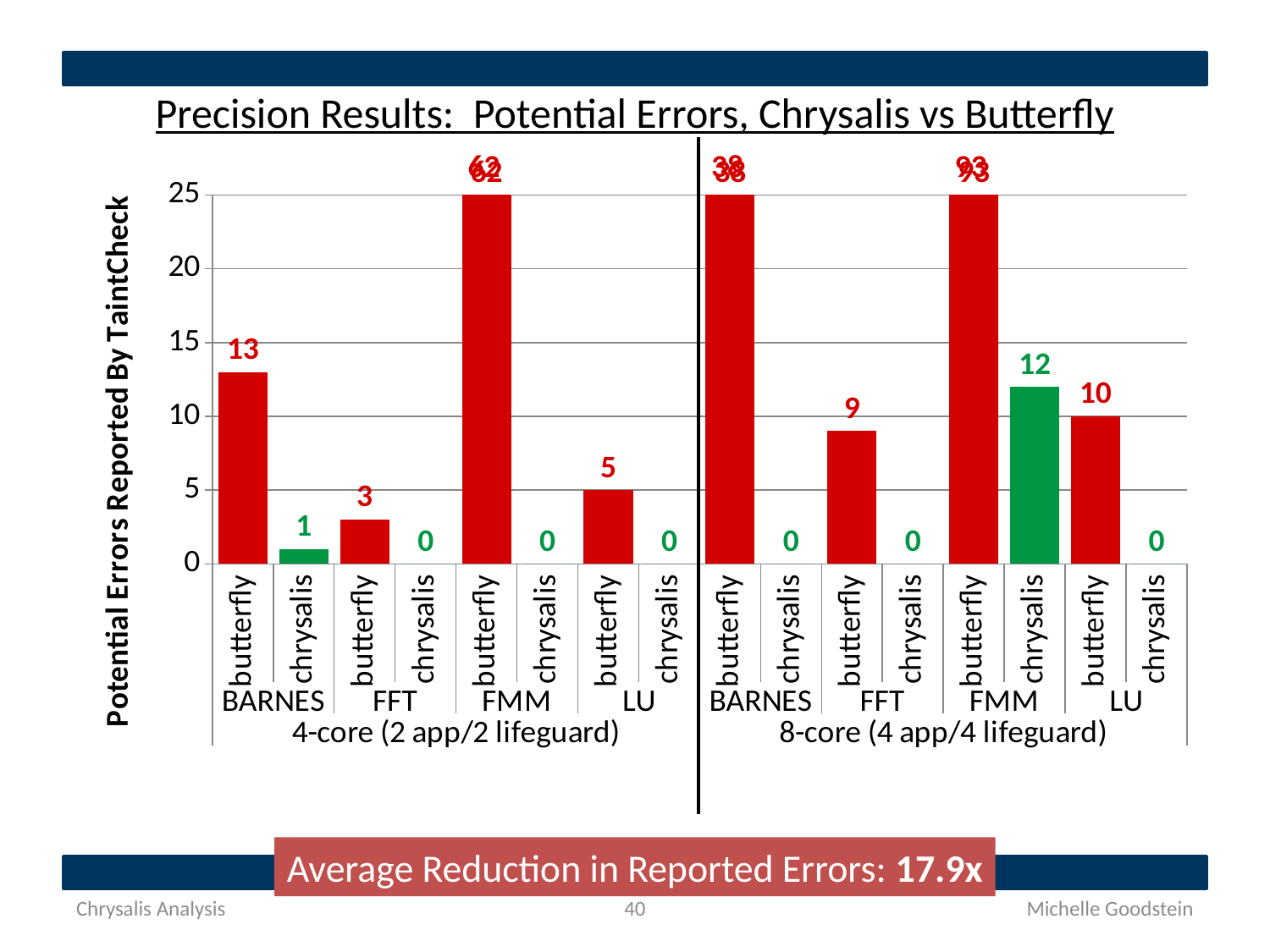
What kind of chart is shown on the slide? bar chart What is the value for butterfly on FFT in the 8-core (4 app/4 lifeguard) configuration? 9 What is the difference between butterfly and chrysalis on BARNES in the 4-core (2 app/2 lifeguard) configuration? 12 What is the value for chrysalis on BARNES in the 4-core (2 app/2 lifeguard) configuration? 1 What is the value for butterfly on LU in the 8-core (4 app/4 lifeguard) configuration? 10 What is the difference between butterfly on LU in the 8-core configuration and butterfly on LU in the 4-core configuration? 5 Which is larger: butterfly on FFT in the 4-core configuration or butterfly on FFT in the 8-core configuration? butterfly on FFT in the 8-core configuration What is the value for chrysalis on FMM in the 8-core (4 app/4 lifeguard) configuration? 12 Is the value for butterfly on FMM in the 4-core (2 app/2 lifeguard) configuration greater or less than 20? greater What is the value for butterfly on LU in the 4-core (2 app/2 lifeguard) configuration? 5 What is the value for butterfly on BARNES in the 4-core (2 app/2 lifeguard) configuration? 13 What is the title of the vertical axis? Potential Errors Reported By TaintCheck